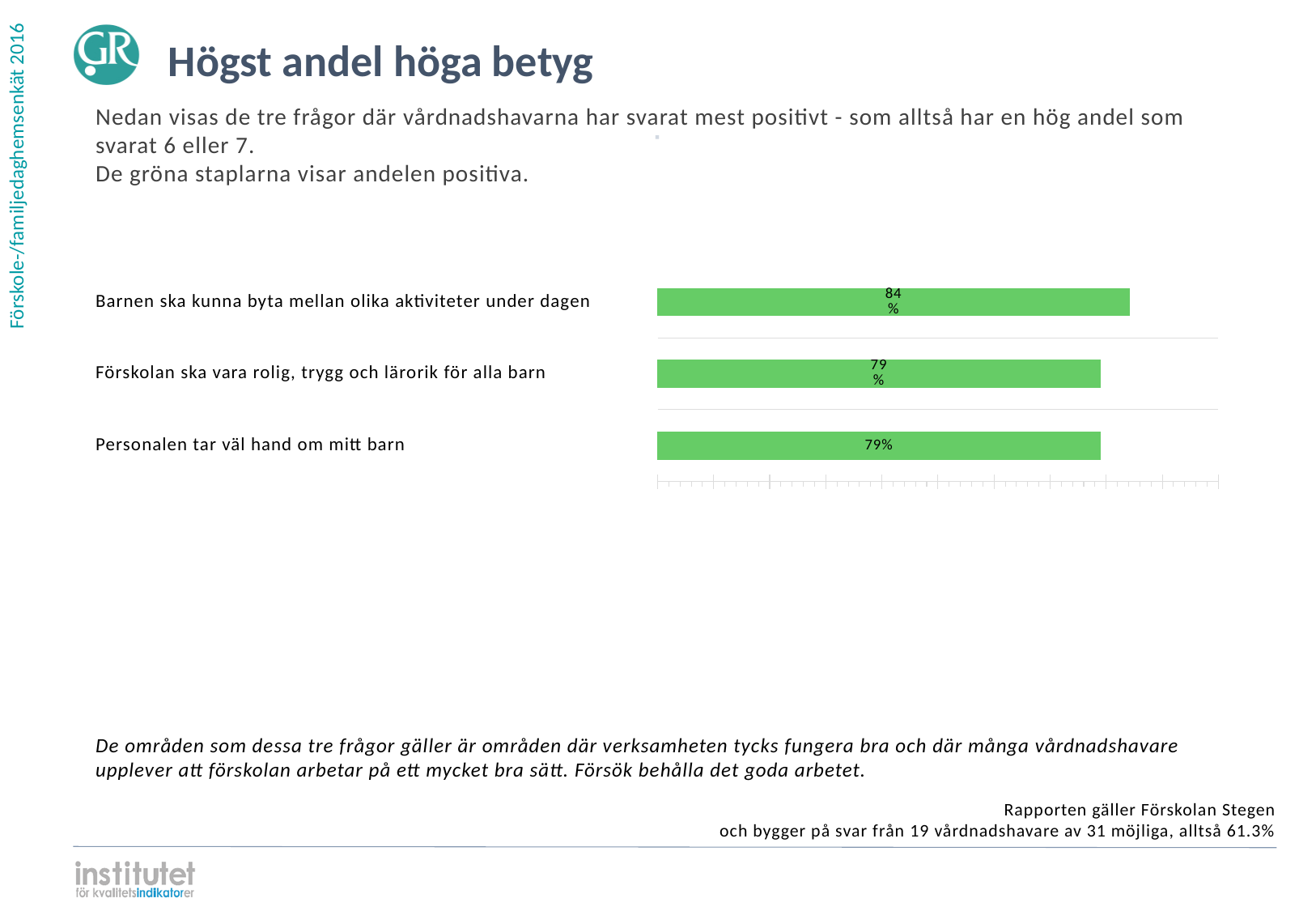
What is the difference between the value for "Barnen ska kunna byta mellan olika aktiviteter under dagen" and the value for "Personalen tar väl hand om mitt barn"? 5 percentage points What is the value for "Förskolan ska vara rolig, trygg och lärorik för alla barn"? 79% What is the value for "Barnen ska kunna byta mellan olika aktiviteter under dagen"? 84% Which is larger: the value for "Barnen ska kunna byta mellan olika aktiviteter under dagen" or the value for "Förskolan ska vara rolig, trygg och lärorik för alla barn"? Barnen ska kunna byta mellan olika aktiviteter under dagen How many categories are shown in the chart? 3 What is the value for "Personalen tar väl hand om mitt barn"? 79% What is the title of the slide containing the chart? Högst andel höga betyg What colour are the bars in the chart? Green What kind of chart is shown on the slide? Bar chart Which category has the highest value? Barnen ska kunna byta mellan olika aktiviteter under dagen